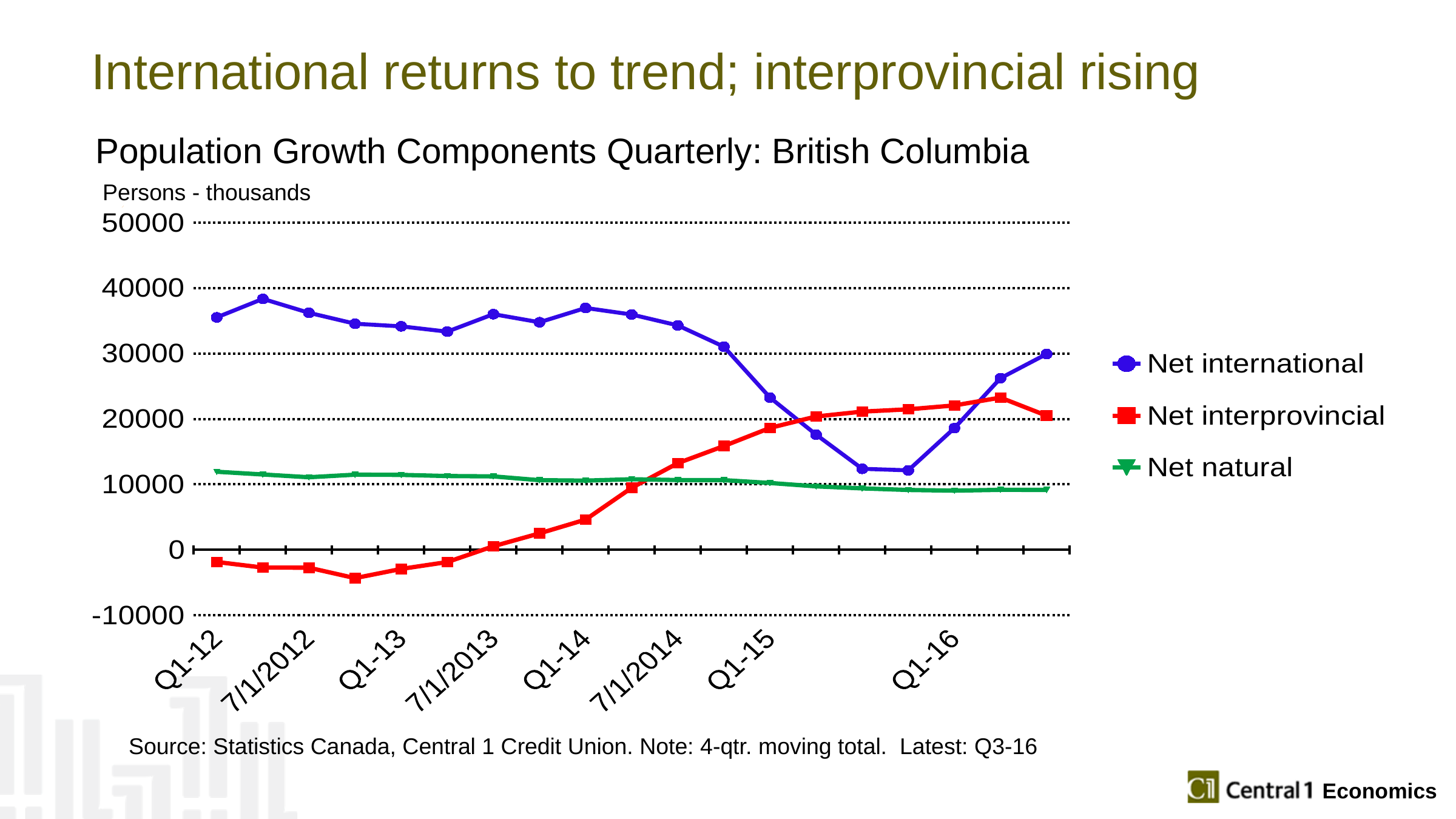
Is the value for Net interprovincial at Q1-12 greater or less than 0? less At Q1-16, which is larger: Net interprovincial or Net natural? Net interprovincial What kind of chart is shown on the slide? line chart Which series has the highest value at Q1-12? Net international What unit is shown on the vertical axis label? Persons - thousands How many series does the legend list? 3 Does the Net interprovincial series rise or fall overall from Q1-12 to the end of the chart? rise Is the value for Net interprovincial at Q1-14 greater or less than 10000? less Which series has the lowest value at Q1-12? Net interprovincial Is the value for Net international at Q1-12 greater or less than 30000? greater What is the title of the chart? Population Growth Components Quarterly: British Columbia